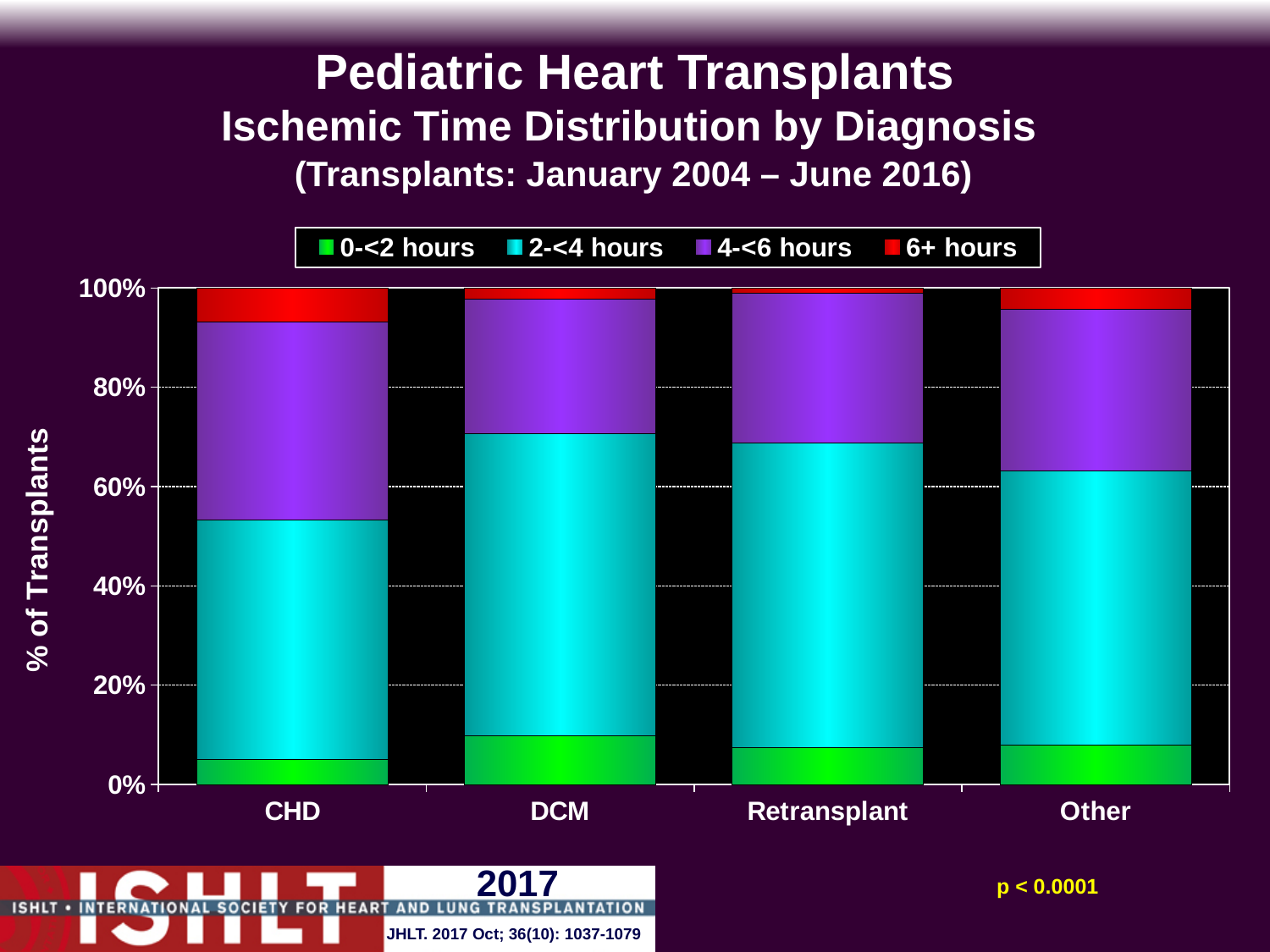
Which has a larger share of 0-<2 hours ischemic time, CHD or DCM? DCM How many diagnosis categories are shown on the x axis? 4 Is the combined share of 0-<2 hours and 2-<4 hours for CHD greater or less than 60%? less Which diagnosis has the largest share of transplants with an ischemic time of 4-<6 hours? CHD How many ischemic time series does the legend list? 4 Which diagnosis has the largest share of transplants with an ischemic time of 6+ hours? CHD Which has a larger share of 4-<6 hours ischemic time, CHD or DCM? CHD Which diagnosis has the smallest share of transplants with an ischemic time of 2-<4 hours? CHD Is the combined share of 0-<2 hours and 2-<4 hours for DCM greater or less than 60%? greater What is the label of the y axis? % of Transplants Is the share of 0-<2 hours for Retransplant greater or less than 20%? less What kind of chart is shown on the slide? Stacked bar chart